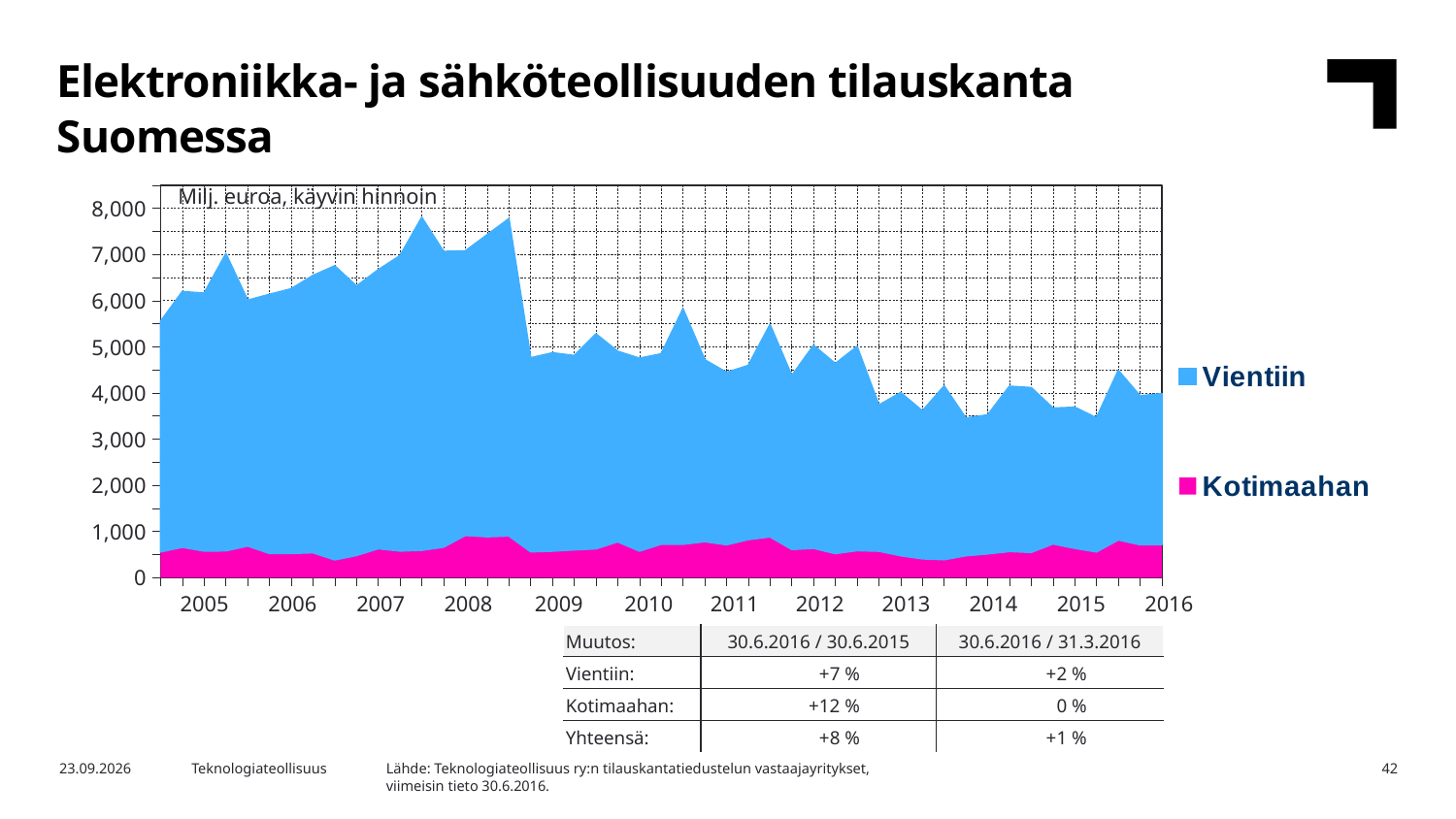
What is the highest value shown on the y axis? 8,000 Which series is larger throughout the chart, Vientiin or Kotimaahan? Vientiin What are the two series named in the legend? Vientiin and Kotimaahan What kind of chart is shown on the slide? area chart Is the total order backlog at the start of 2005 greater or less than 5,000? greater Is the total order backlog in 2007 greater or less than 6,000? greater How many years are labelled on the x axis? 12 Is the total order backlog in 2014 greater or less than 5,000? less How many series does the legend list? 2 Does the total order backlog rise or fall between 2008 and 2016? fall What unit label is shown at the top of the chart? Milj. euroa, käyvin hinnoin